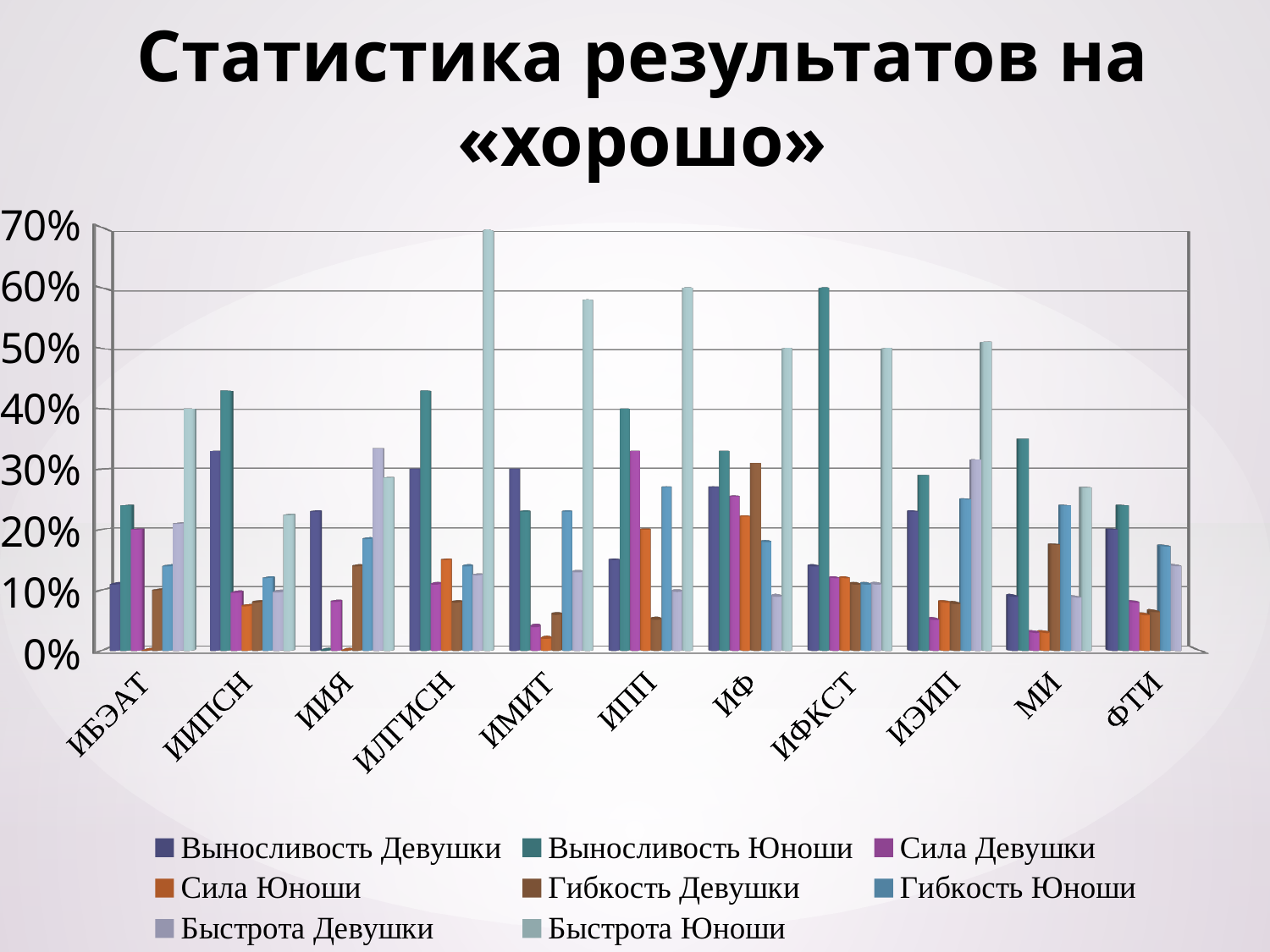
How many series does the legend list? 8 What is the title of the slide? Статистика результатов на «хорошо» Which category has the highest value for Быстрота Юноши? ИЛГИСН Is the value for Быстрота Юноши at ИМИТ greater or less than 50%? greater What kind of chart is shown on the slide? bar chart Which is larger: Быстрота Юноши at ИПП or Быстрота Юноши at ИФ? ИПП Which is larger: Выносливость Юноши at ИИПСН or Выносливость Юноши at ИЭИП? ИИПСН Which category has the highest value for Выносливость Юноши? ИФКСТ Is the value for Выносливость Юноши at ИИЯ greater or less than 10%? less How many categories (institutes) are shown along the x axis? 11 What is the highest value shown on the vertical axis? 70% Is the value for Выносливость Юноши at ИФКСТ greater or less than 50%? greater